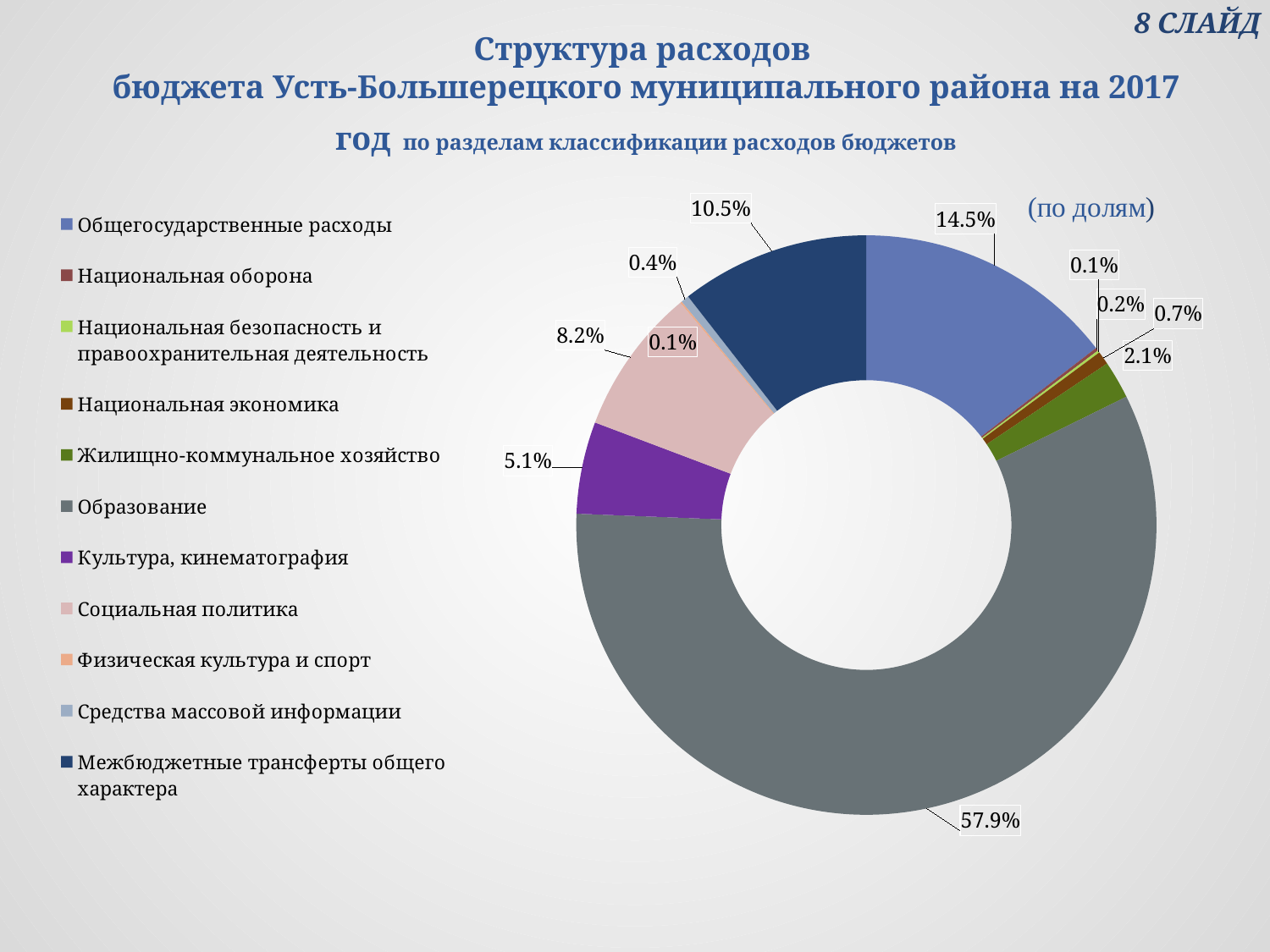
What is the difference between the share for Общегосударственные расходы and the share for Межбюджетные трансферты общего характера? 4.0% What share of expenditures goes to Общегосударственные расходы? 14.5% What is the difference between the share for Образование and the share for Общегосударственные расходы? 43.4% What share of expenditures goes to Межбюджетные трансферты общего характера? 10.5% How many categories are listed in the legend? 11 What share of expenditures goes to Образование? 57.9% Which is larger: the share for Социальная политика or the share for Культура, кинематография? Социальная политика What share of expenditures goes to Социальная политика? 8.2% What kind of chart is shown on the slide? Doughnut (pie) chart What share of expenditures goes to Культура, кинематография? 5.1% Which category has the largest share of expenditures? Образование What share of expenditures goes to Жилищно-коммунальное хозяйство? 2.1%